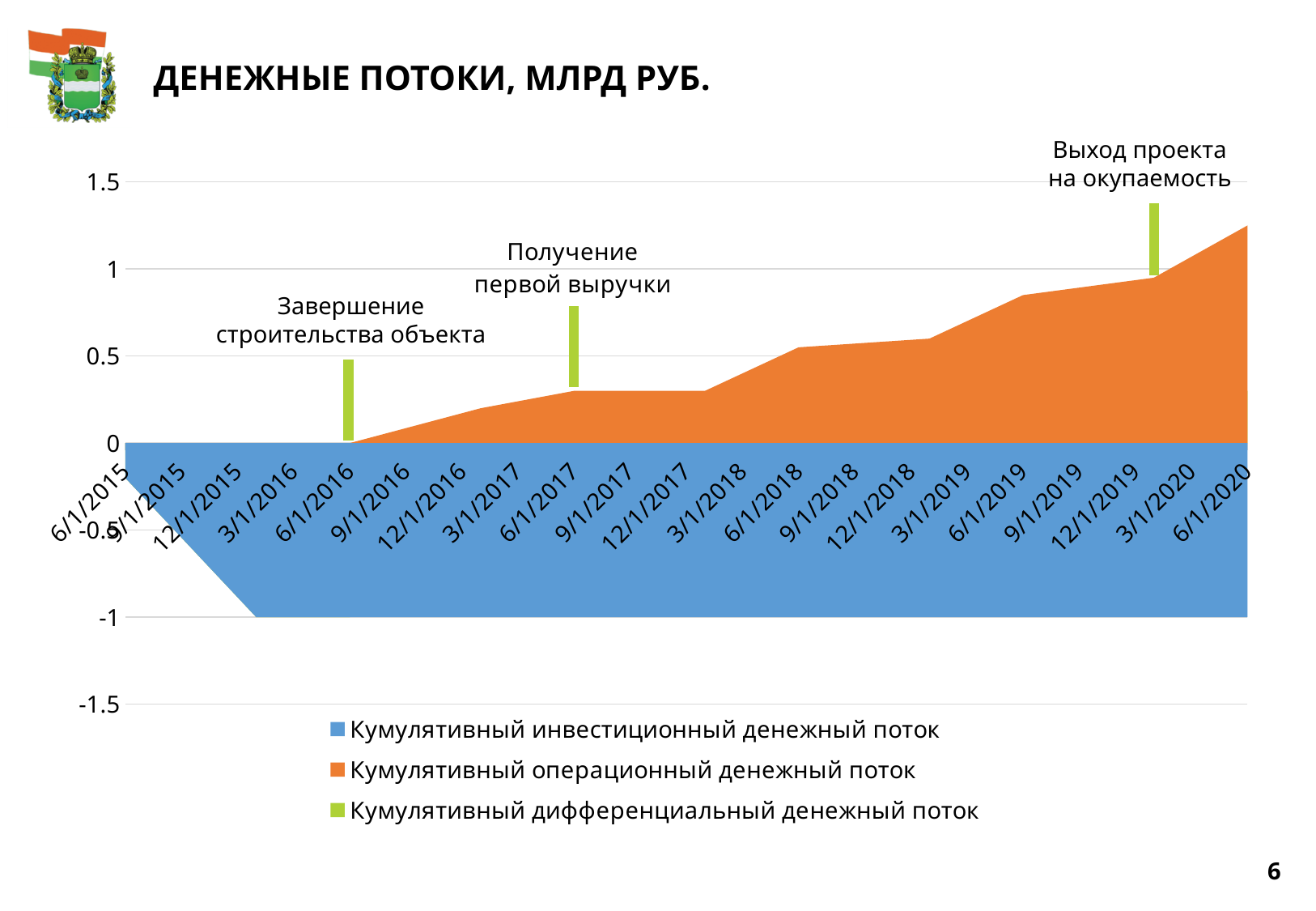
What is the value of the cumulative investment cash flow (blue) at 6/1/2018? -1 Is the cumulative operating cash flow (orange) at 6/1/2020 greater or less than 1? greater How many dates are shown along the x axis? 21 What kind of chart is shown on the slide? area chart How many series does the legend list? 3 Which is larger for the cumulative operating cash flow (orange): the value at 6/1/2019 or at 6/1/2020? 6/1/2020 What is the title of the chart? ДЕНЕЖНЫЕ ПОТОКИ, МЛРД РУБ. Does the cumulative operating cash flow (orange) rise or fall from 6/1/2016 to 6/1/2020? rise Which series is shown in orange? Кумулятивный операционный денежный поток Is the cumulative operating cash flow (orange) at 6/1/2017 greater or less than 0.5? less